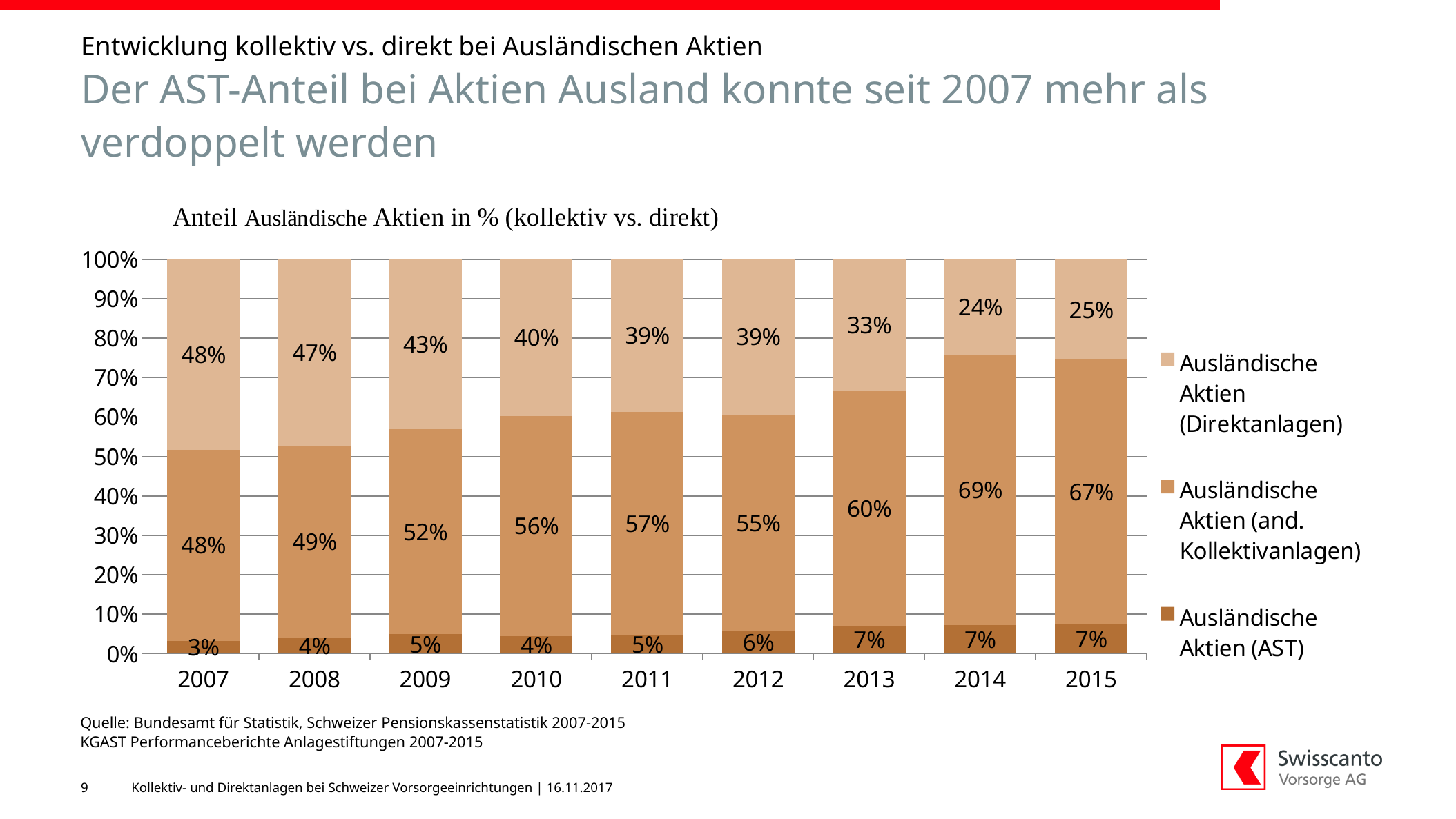
In which year is the Ausländische Aktien (Direktanlagen) share lowest? 2014 What is the value for Ausländische Aktien (AST) in 2007? 3% Does the Ausländische Aktien (Direktanlagen) share generally rise or fall from 2007 to 2015? fall What type of chart is shown on the slide? stacked bar chart How many series does the legend list? 3 What is the value for Ausländische Aktien (and. Kollektivanlagen) in 2011? 57% In which year is the Ausländische Aktien (and. Kollektivanlagen) share highest? 2014 Which is larger in 2013: the Ausländische Aktien (and. Kollektivanlagen) share or the Ausländische Aktien (Direktanlagen) share? Ausländische Aktien (and. Kollektivanlagen) What is the difference between the Ausländische Aktien (Direktanlagen) share in 2007 and in 2015? 23% How many years are shown on the x axis? 9 What is the value for Ausländische Aktien (Direktanlagen) in 2014? 24% What is the title of the chart? Anteil Ausländische Aktien in % (kollektiv vs. direkt)